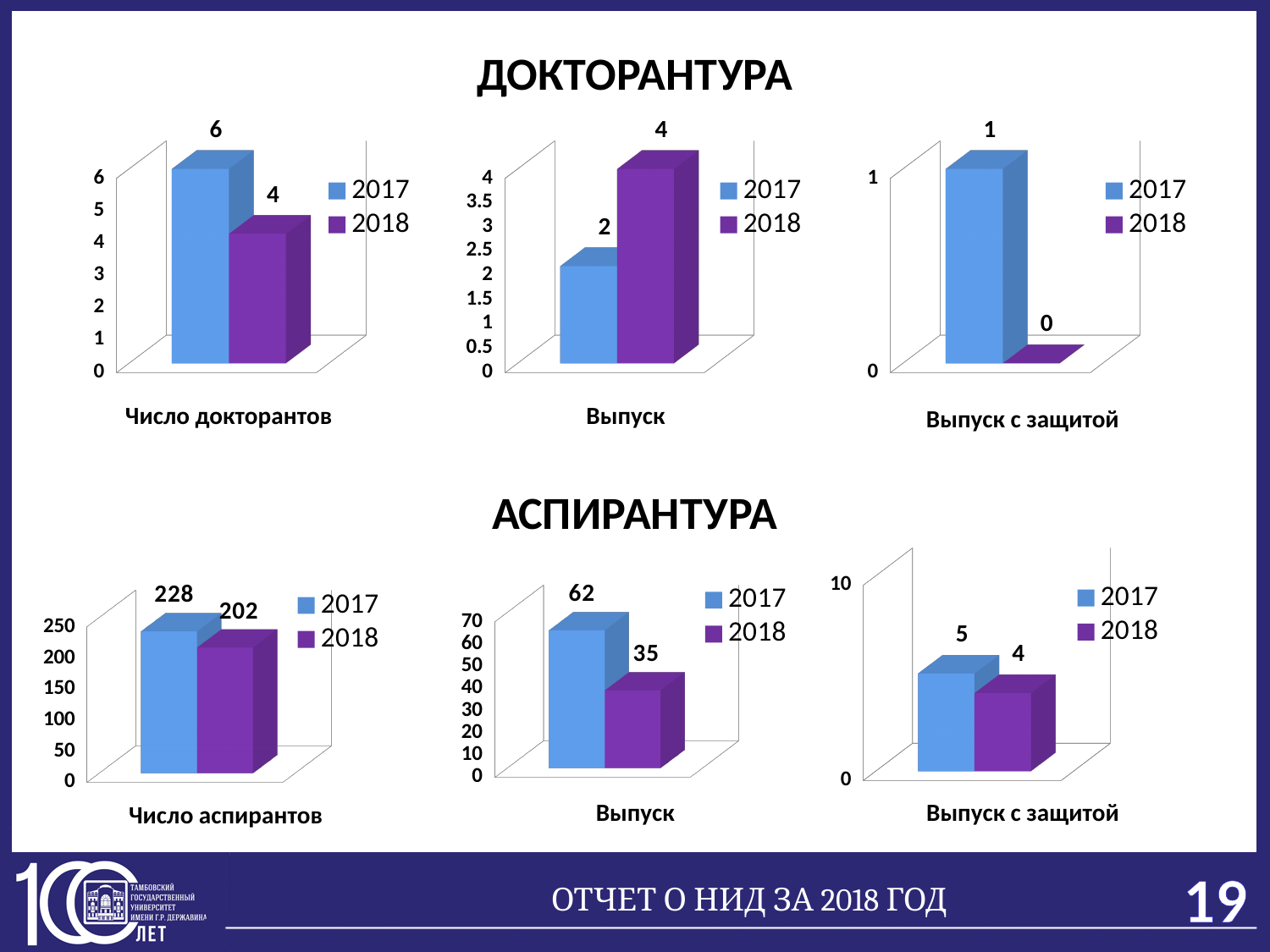
In the ДОКТОРАНТУРА section, on the chart titled 'Выпуск', what is the value for 2018? 4 In the АСПИРАНТУРА section, on the chart titled 'Число аспирантов', what is the difference between the 2017 and 2018 values? 26 In the АСПИРАНТУРА section, on the chart titled 'Число аспирантов', what is the value for 2017? 228 In the ДОКТОРАНТУРА section, on the chart titled 'Число докторантов', what is the value for 2018? 4 In the АСПИРАНТУРА section, on the chart titled 'Выпуск', what is the value for 2018? 35 In the АСПИРАНТУРА section, on the chart titled 'Выпуск', what is the difference between the 2017 and 2018 values? 27 What kind of chart is the 'Число докторантов' chart in the ДОКТОРАНТУРА section? Bar chart In the ДОКТОРАНТУРА section, on the chart titled 'Выпуск с защитой', what is the value for 2018? 0 In the АСПИРАНТУРА section, on the chart titled 'Выпуск с защитой', what is the value for 2017? 5 In the ДОКТОРАНТУРА section, on the chart titled 'Число докторантов', what is the value for 2017? 6 In the АСПИРАНТУРА section, on the chart titled 'Выпуск с защитой', how many series does the legend list? 2 In the ДОКТОРАНТУРА section, on the chart titled 'Выпуск', which year has the larger value, 2017 or 2018? 2018